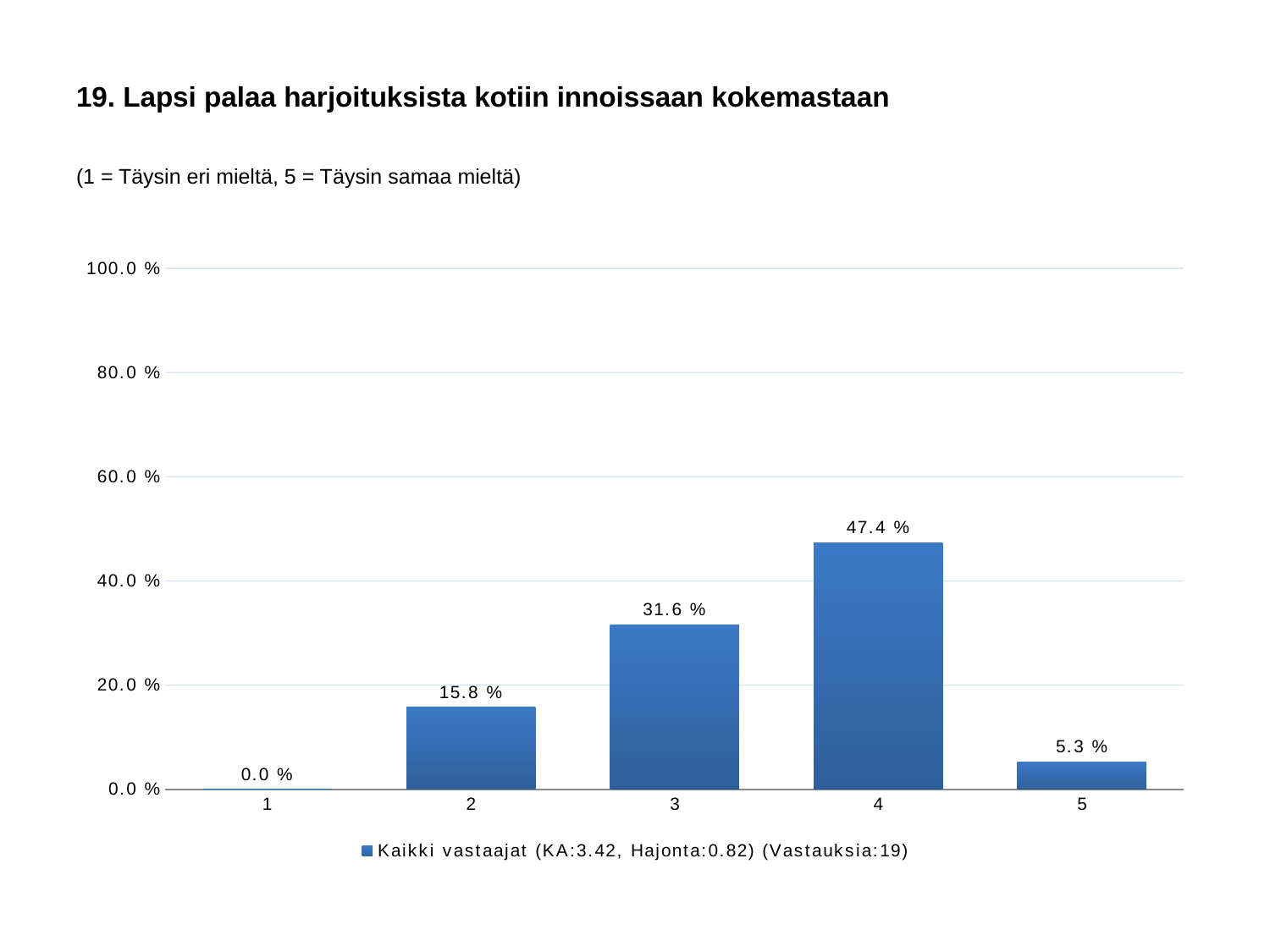
What is the value for category 4? 47.4 % According to the legend, how many responses (Vastauksia) were there? 19 How many categories are shown on the x axis? 5 Which category has the highest value? 4 How many series does the legend list? 1 What is the value for category 2? 15.8 % What kind of chart is shown on the slide? bar chart What is the difference between the values for category 4 and category 3? 15.8 % What is the value for category 5? 5.3 % Which is larger, the value for category 2 or the value for category 5? 2 Is the value for category 3 greater or less than 40.0 %? less Which category has the lowest value? 1